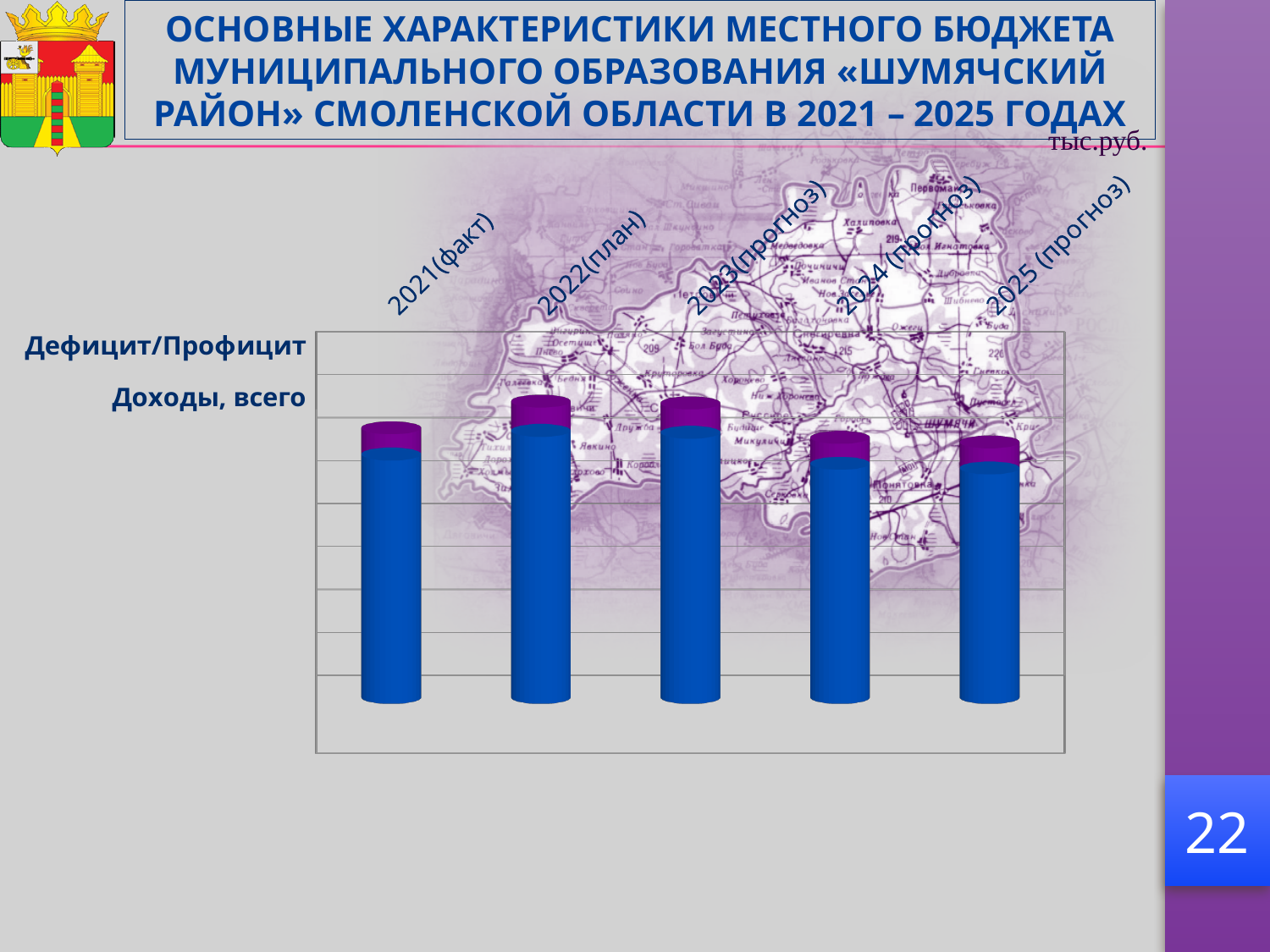
In what unit are the values of the chart expressed, according to the label above the chart? тыс.руб. Do the Доходы, всего bars rise or fall from 2023(прогноз) to 2025 (прогноз)? fall What kind of chart is shown on the slide? bar chart How many year categories are shown along the x axis of the chart? 5 Which series is shown in blue in the chart? Доходы, всего Which is larger for Доходы, всего: the bar for 2023(прогноз) or the bar for 2025 (прогноз)? 2023(прогноз) Do the Доходы, всего bars rise or fall from 2021(факт) to 2022(план)? rise Which is larger for Доходы, всего: the bar for 2022(план) or the bar for 2021(факт)? 2022(план) Which category is labelled as the actual (факт) value in the chart? 2021(факт)